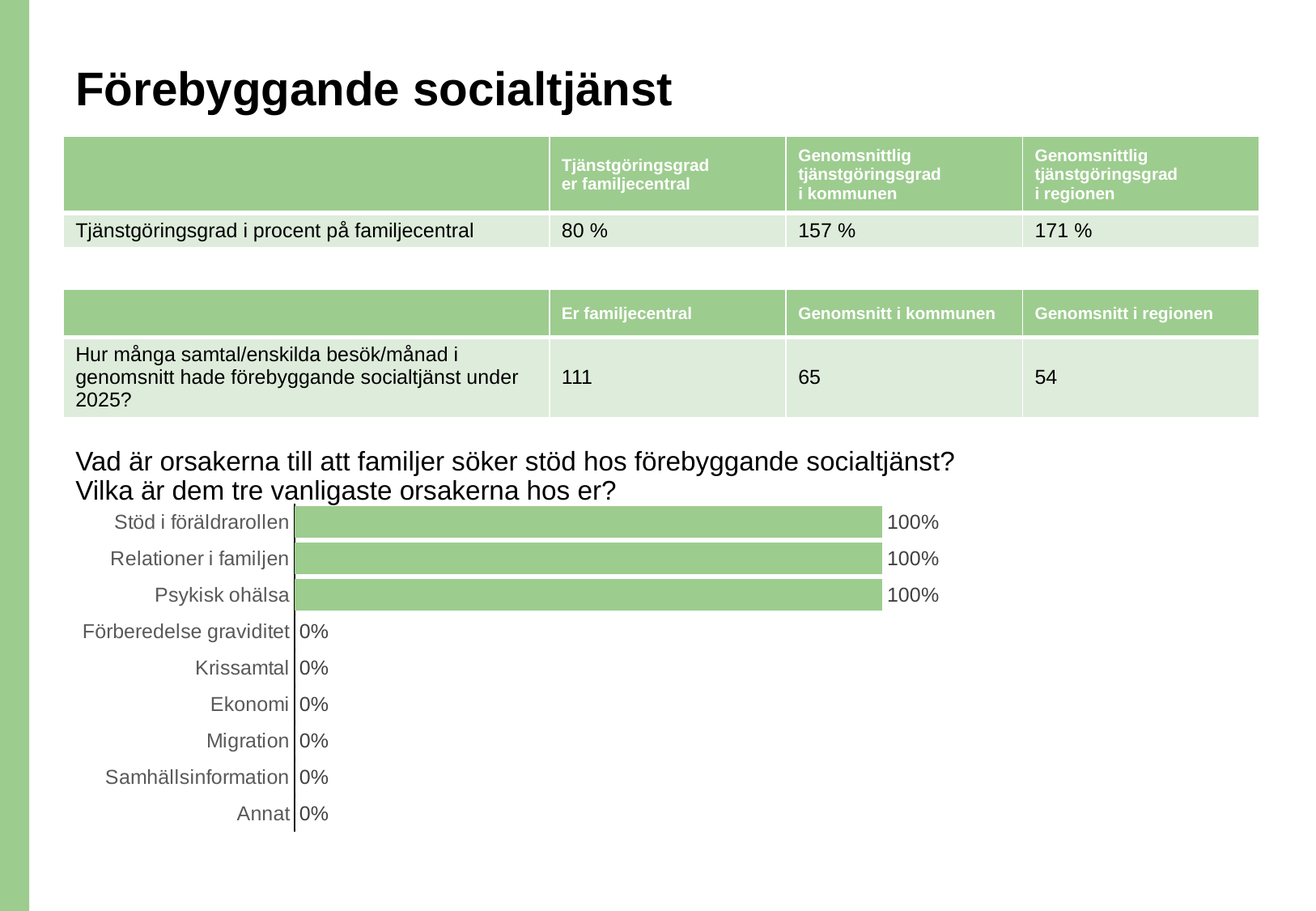
What kind of chart is shown on the slide? Bar chart What colour are the bars in the chart? Green Which has the larger value in the bar chart, Samhällsinformation or Relationer i familjen? Relationer i familjen What is the difference between the values for Relationer i familjen and Krissamtal in the bar chart? 100% What value is shown for Ekonomi in the bar chart? 0% What value is shown for Stöd i föräldrarollen in the bar chart? 100% What value is shown for Migration in the bar chart? 0% How many categories in the bar chart have a value of 0%? 6 Which has the larger value in the bar chart, Psykisk ohälsa or Annat? Psykisk ohälsa How many categories in the bar chart have a value of 100%? 3 How many categories are shown in the bar chart? 9 What value is shown for Psykisk ohälsa in the bar chart? 100%